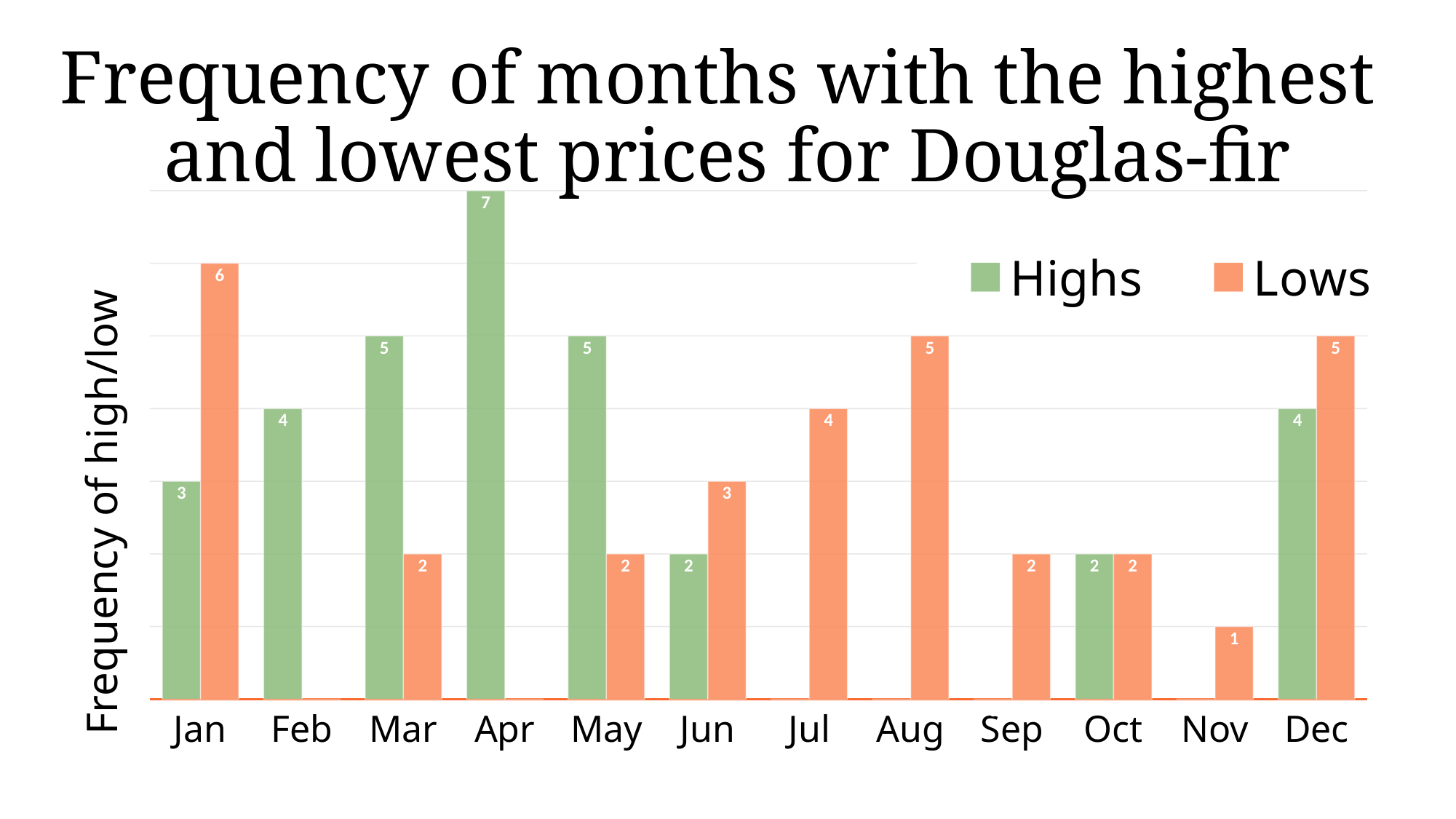
What is the difference between the Highs value for Apr and the Highs value for Jan? 4 What kind of chart is shown on the slide? Bar chart What is the Highs value for Dec? 4 How many months are shown on the x axis? 12 What is the Lows value for Jan? 6 What is the Lows value for Nov? 1 Which month has the lowest non-zero Lows value? Nov Which month has the highest Lows value? Jan How many series does the legend list? 2 Which month has the highest Highs value? Apr Which is larger, the Lows value for Aug or the Lows value for Jul? Aug What is the Highs value for Apr? 7